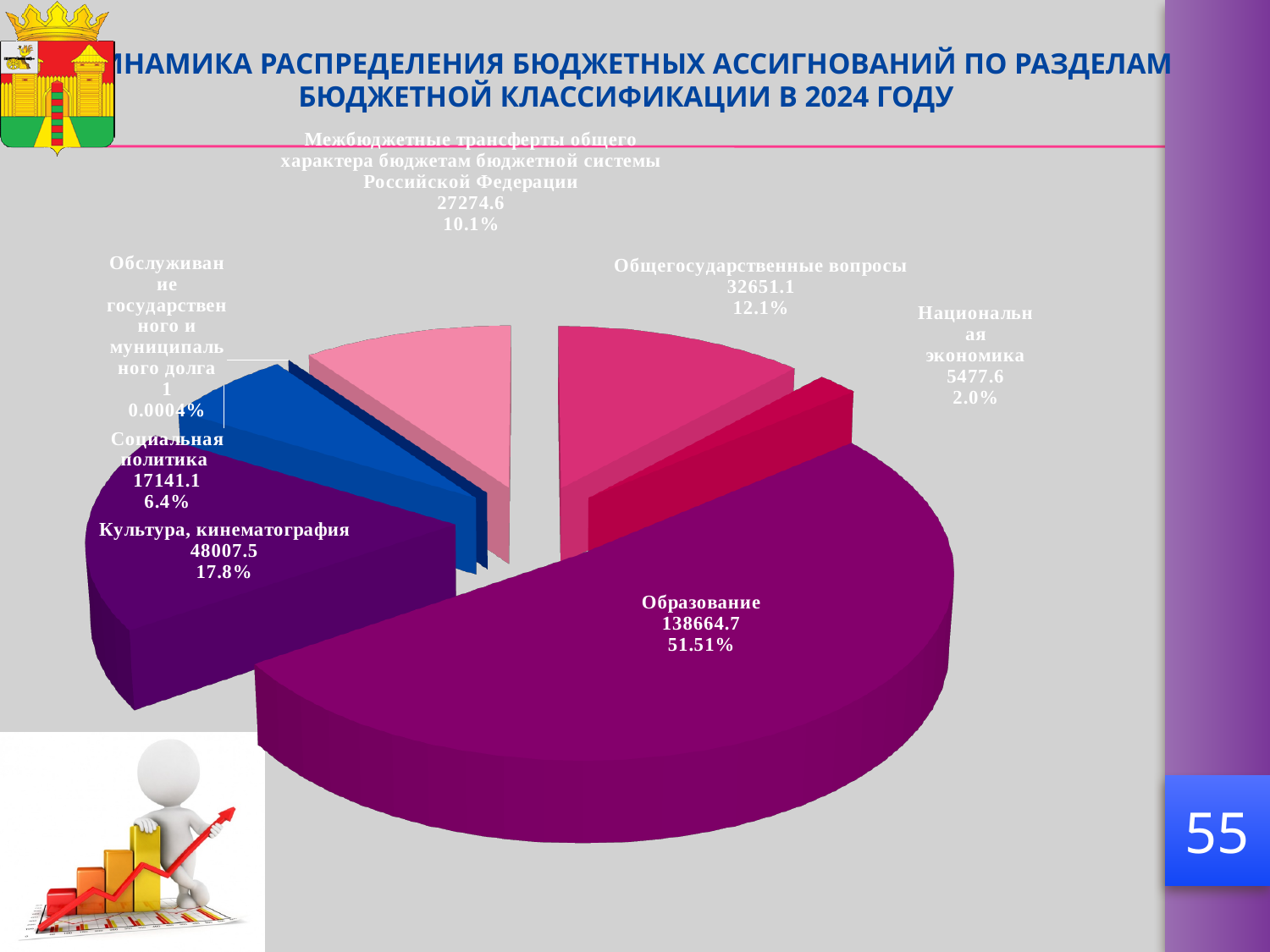
Which category has the smallest slice of the pie? Обслуживание государственного и муниципального долга What is the difference between the values for Культура, кинематография and Социальная политика? 30866.4 Which is larger: the value for Общегосударственные вопросы or the value for Межбюджетные трансферты общего характера бюджетам бюджетной системы Российской Федерации? Общегосударственные вопросы What percentage is shown for Национальная экономика? 2.0% What is the value shown for Культура, кинематография? 48007.5 What is the value shown for Образование? 138664.7 What share of the pie does Образование represent? 51.51% How many categories (slices) does the pie chart show? 7 Which category has the largest slice of the pie? Образование What kind of chart is shown on the slide? Pie chart What percentage is shown for Социальная политика? 6.4% What is the value shown for Общегосударственные вопросы? 32651.1